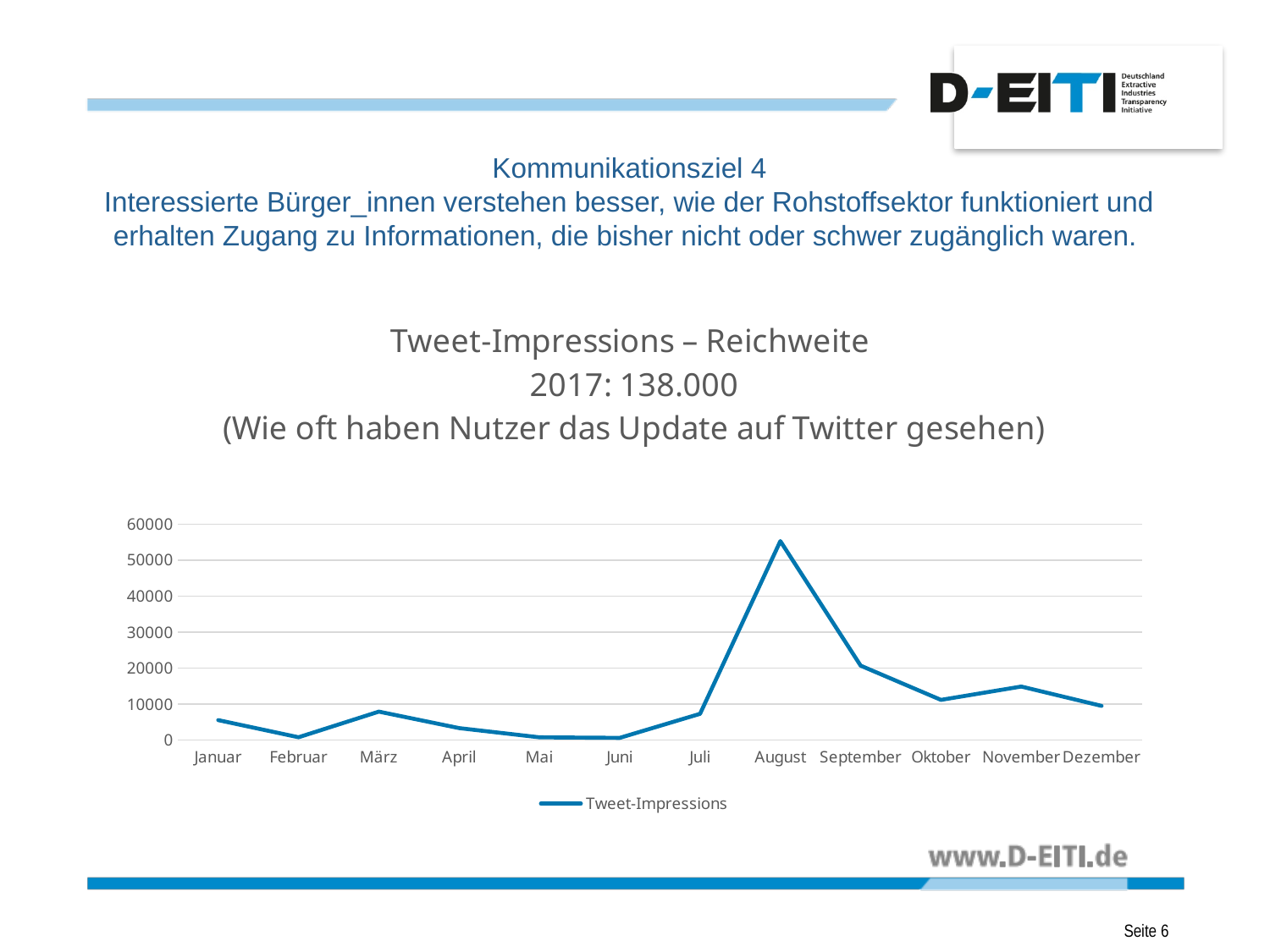
Which month has the higher value, November or Oktober? November In which month do Tweet-Impressions reach their highest value? August Is the value for August greater or less than 50000? greater Is the value for September greater or less than 10000? greater How many months are plotted along the x axis? 12 Is the value for Juli greater or less than 10000? less What kind of chart is shown on the slide? line chart How many series does the legend list? 1 Do the values rise or fall from August to Dezember? fall Which month has the higher value, August or September? August What is the name of the series shown in the legend? Tweet-Impressions